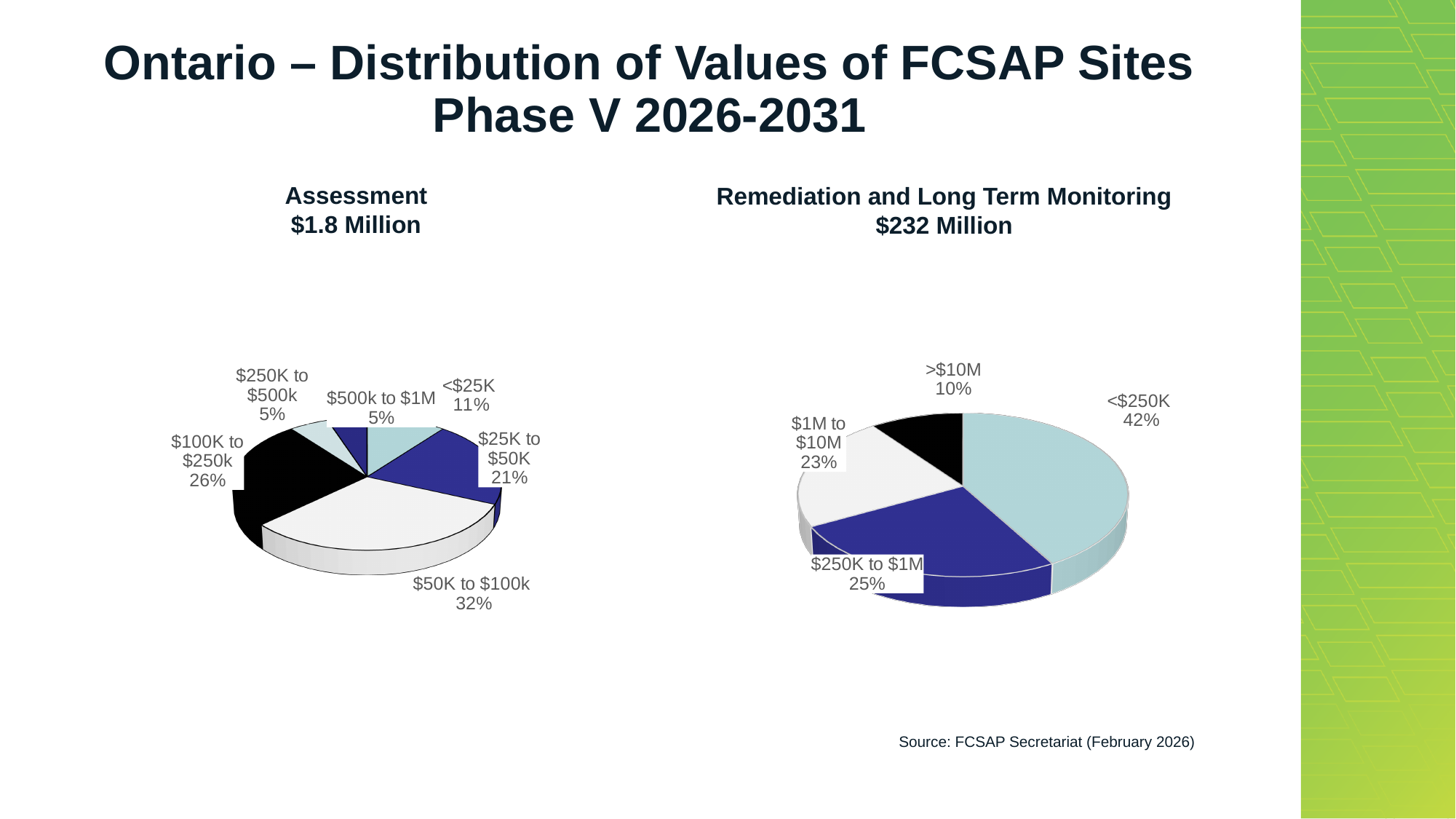
What total dollar value is given in the title of the Remediation and Long Term Monitoring chart? $232 Million In the Assessment pie chart, what share is labelled for $100K to $250k? 26% In the Assessment pie chart, what is the difference between the shares for $25K to $50K and <$25K? 10% In the Remediation and Long Term Monitoring pie chart, how many categories are shown? 4 In the Remediation and Long Term Monitoring pie chart, what is the difference between the shares for $250K to $1M and $1M to $10M? 2% What kind of chart is used on the right side of the slide for Remediation and Long Term Monitoring? Pie chart In the Remediation and Long Term Monitoring pie chart, which category has the smallest share? >$10M In the Assessment pie chart, which is larger: the share for $100K to $250k or the share for $25K to $50K? $100K to $250k In the Assessment pie chart, which category has the largest share? $50K to $100k In the Assessment pie chart, how many categories are shown? 6 In the Assessment pie chart, what share is labelled for $50K to $100k? 32% In the Remediation and Long Term Monitoring pie chart, what share is labelled for <$250K? 42%